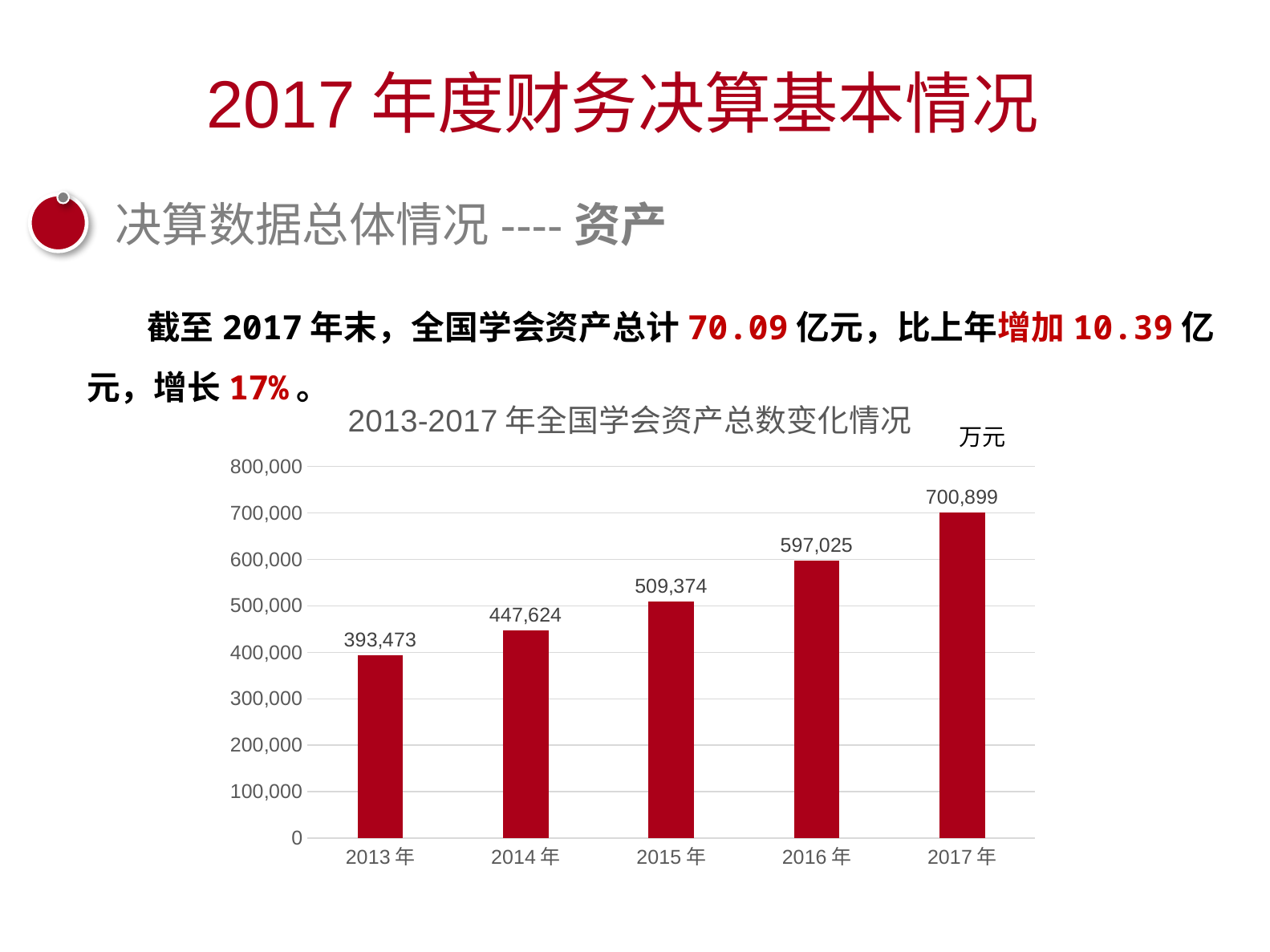
What is the value for 2015年 in the chart? 509,374 What kind of chart is shown on the slide? bar chart Which is larger, the value for 2015年 or the value for 2014年? 2015年 What is the value for 2016年 in the chart? 597,025 What is the difference between the values for 2014年 and 2013年? 54,151 What is the value for 2013年 in the chart? 393,473 Do the values rise or fall from 2013年 to 2017年? rise What is the difference between the values for 2017年 and 2016年? 103,874 Which year has the highest value in the chart? 2017年 How many years are shown on the x axis of the chart? 5 Which year has the lowest value in the chart? 2013年 Is the value for 2016年 greater or less than 500,000? greater